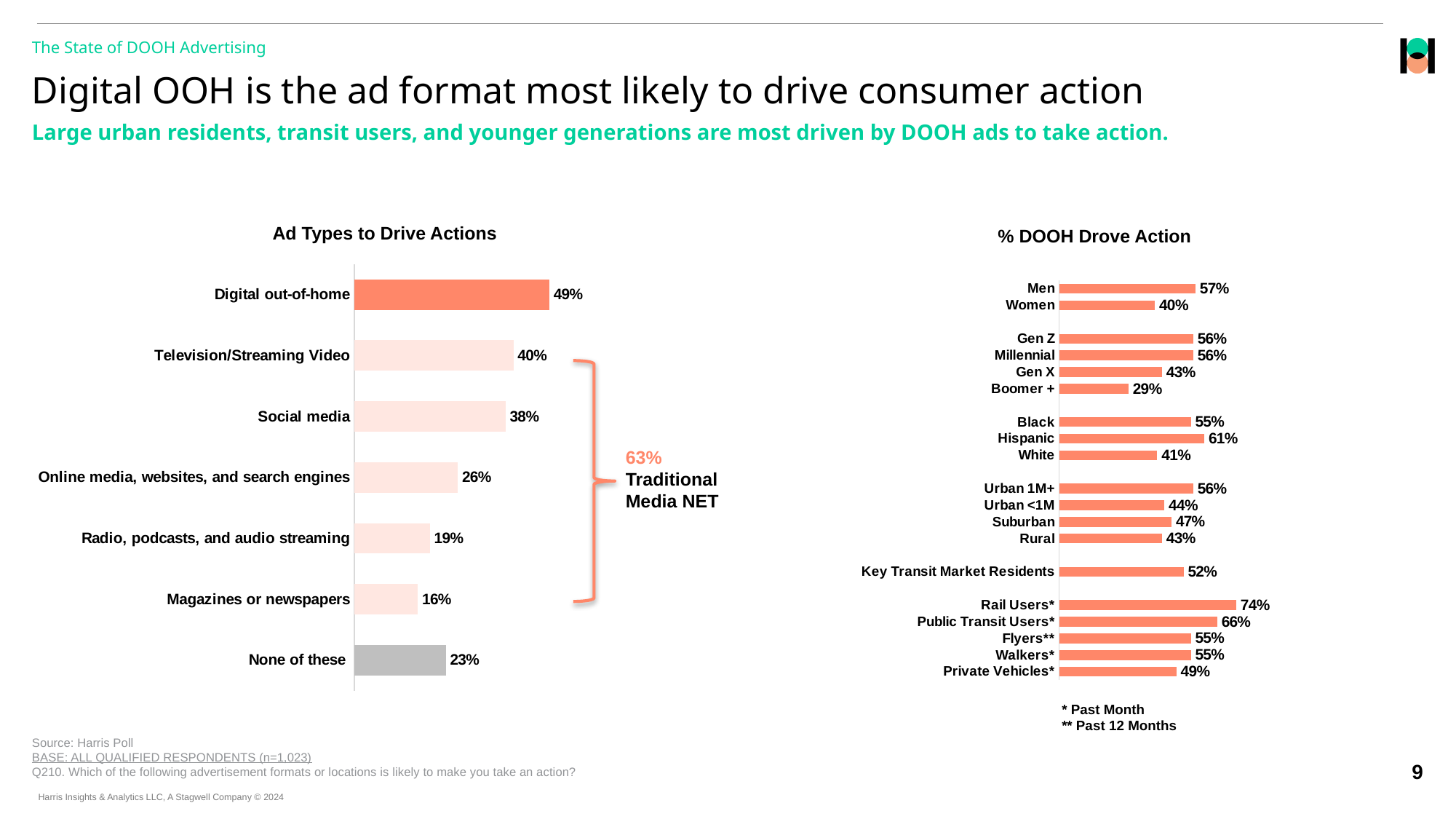
In the '% DOOH Drove Action' chart, what is the difference between Men and Women? 17% In the 'Ad Types to Drive Actions' chart, what is the difference between Television/Streaming Video and Social media? 2% In the '% DOOH Drove Action' chart, what is the value for Rail Users*? 74% In the '% DOOH Drove Action' chart, which group has the highest value? Rail Users* In the 'Ad Types to Drive Actions' chart, what is the value for Digital out-of-home? 49% In the 'Ad Types to Drive Actions' chart, what is the Traditional Media NET value shown next to the bracket? 63% In the 'Ad Types to Drive Actions' chart, how many categories are plotted? 7 In the '% DOOH Drove Action' chart, what is the value for Key Transit Market Residents? 52% What kind of chart is the 'Ad Types to Drive Actions' chart? Bar chart In the '% DOOH Drove Action' chart, which is larger, Hispanic or White? Hispanic In the '% DOOH Drove Action' chart, which group has the lowest value? Boomer + In the 'Ad Types to Drive Actions' chart, which ad type has the lowest value (excluding 'None of these')? Magazines or newspapers